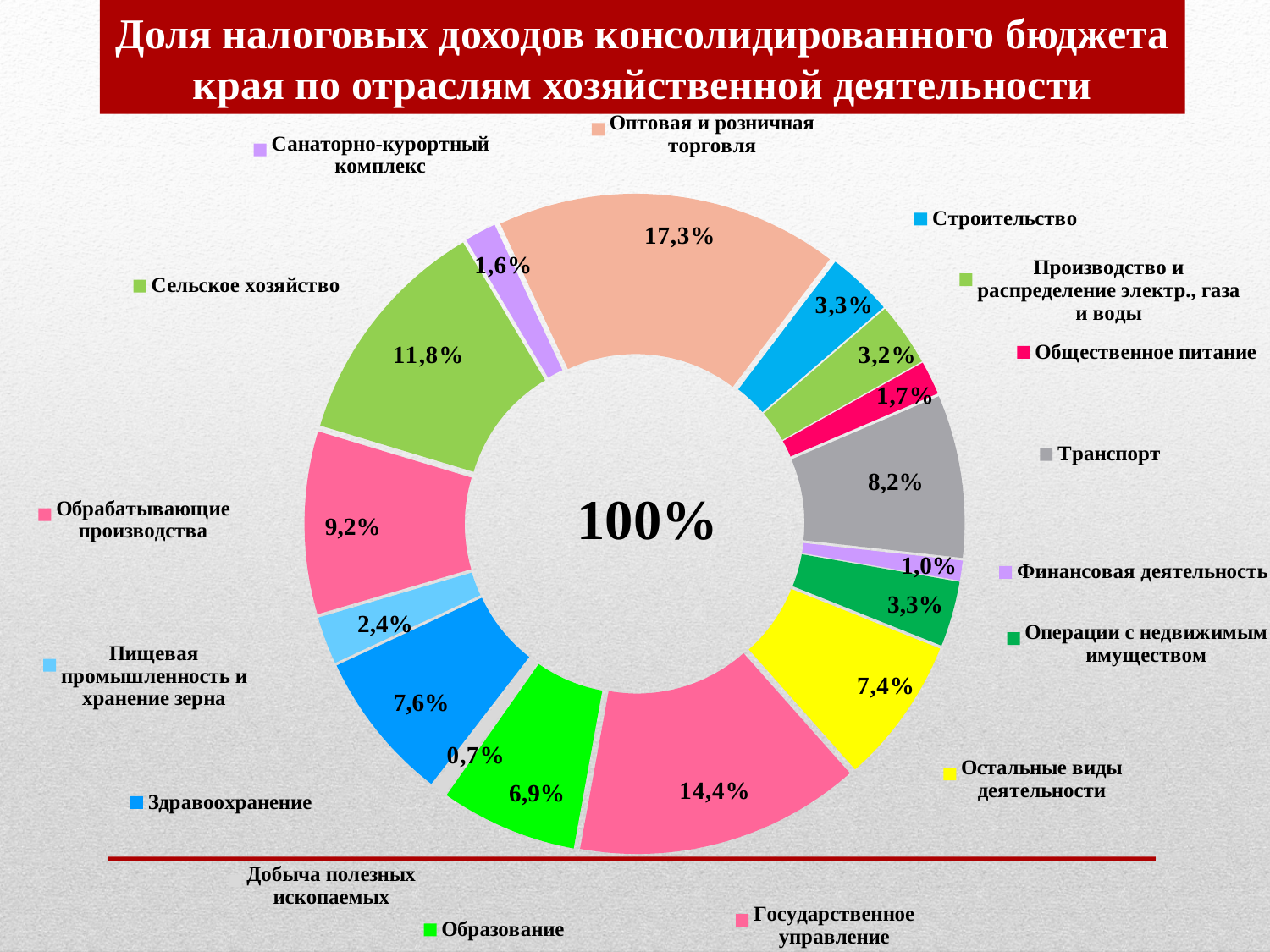
Which is larger: the share of Обрабатывающие производства or the share of Образование? Обрабатывающие производства What is the title of the chart? Доля налоговых доходов консолидированного бюджета края по отраслям хозяйственной деятельности What is the difference between the shares of Оптовая и розничная торговля and Государственное управление? 2,9% Which sector has the largest share of tax revenues? Оптовая и розничная торговля What is the share for Финансовая деятельность? 1,0% Which sector has the smallest share of tax revenues? Добыча полезных ископаемых What is the share for Здравоохранение? 7,6% What is the share for Государственное управление? 14,4% What is the share for Транспорт? 8,2% How many sectors are shown in the chart? 16 What is the share for Сельское хозяйство? 11,8% What kind of chart is shown on the slide? Pie chart (doughnut)